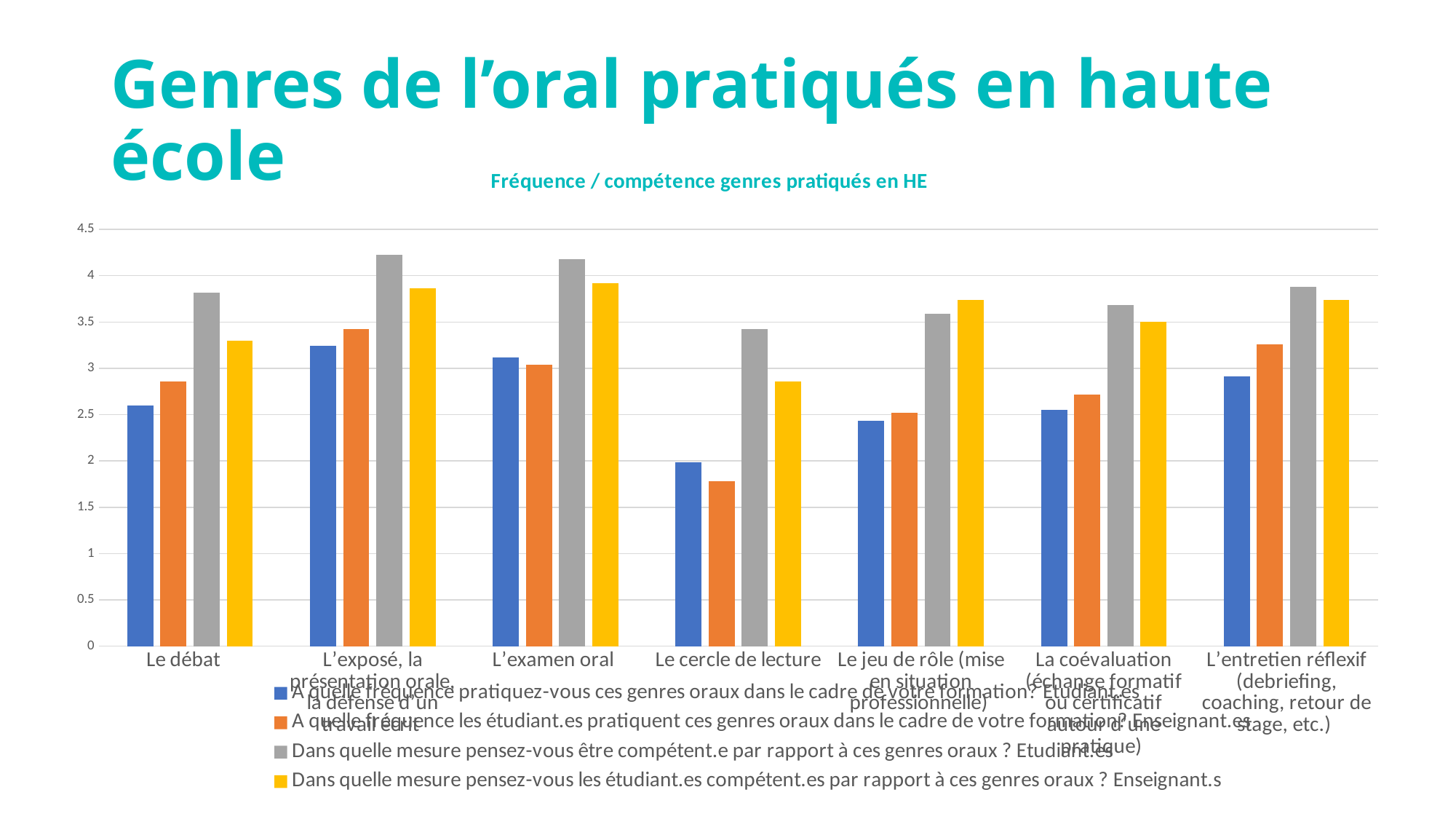
For 'Le cercle de lecture', which is larger: the value for 'A quelle fréquence pratiquez-vous ces genres oraux dans le cadre de votre formation? Etudiant.es' or the value for 'A quelle fréquence les étudiant.es pratiquent ces genres oraux dans le cadre de votre formation? Enseignant.es'? A quelle fréquence pratiquez-vous ces genres oraux dans le cadre de votre formation? Etudiant.es Which colour represents the series 'Dans quelle mesure pensez-vous les étudiant.es compétent.es par rapport à ces genres oraux ? Enseignant.s'? yellow How many categories (oral genres) are shown on the x axis of the chart? 7 What kind of chart is shown on the slide? bar chart For the series 'A quelle fréquence les étudiant.es pratiquent ces genres oraux dans le cadre de votre formation? Enseignant.es', which category has the lowest value? Le cercle de lecture Is the value for 'Le cercle de lecture' in the series 'Dans quelle mesure pensez-vous les étudiant.es compétent.es par rapport à ces genres oraux ? Enseignant.s' greater or less than 3? less How many series does the chart's legend list? 4 Is the value for 'L'exposé, la présentation orale, la défense d'un travail écrit' in the series 'Dans quelle mesure pensez-vous être compétent.e par rapport à ces genres oraux ? Etudiant.es' greater or less than 4? greater What is the title of the chart? Fréquence / compétence genres pratiqués en HE For 'Le débat', which is larger: the value for 'Dans quelle mesure pensez-vous être compétent.e par rapport à ces genres oraux ? Etudiant.es' or the value for 'Dans quelle mesure pensez-vous les étudiant.es compétent.es par rapport à ces genres oraux ? Enseignant.s'? Dans quelle mesure pensez-vous être compétent.e par rapport à ces genres oraux ? Etudiant.es Is the value for 'Le débat' in the series 'A quelle fréquence pratiquez-vous ces genres oraux dans le cadre de votre formation? Etudiant.es' greater or less than 3? less For the series 'A quelle fréquence pratiquez-vous ces genres oraux dans le cadre de votre formation? Etudiant.es', which category has the lowest value? Le cercle de lecture